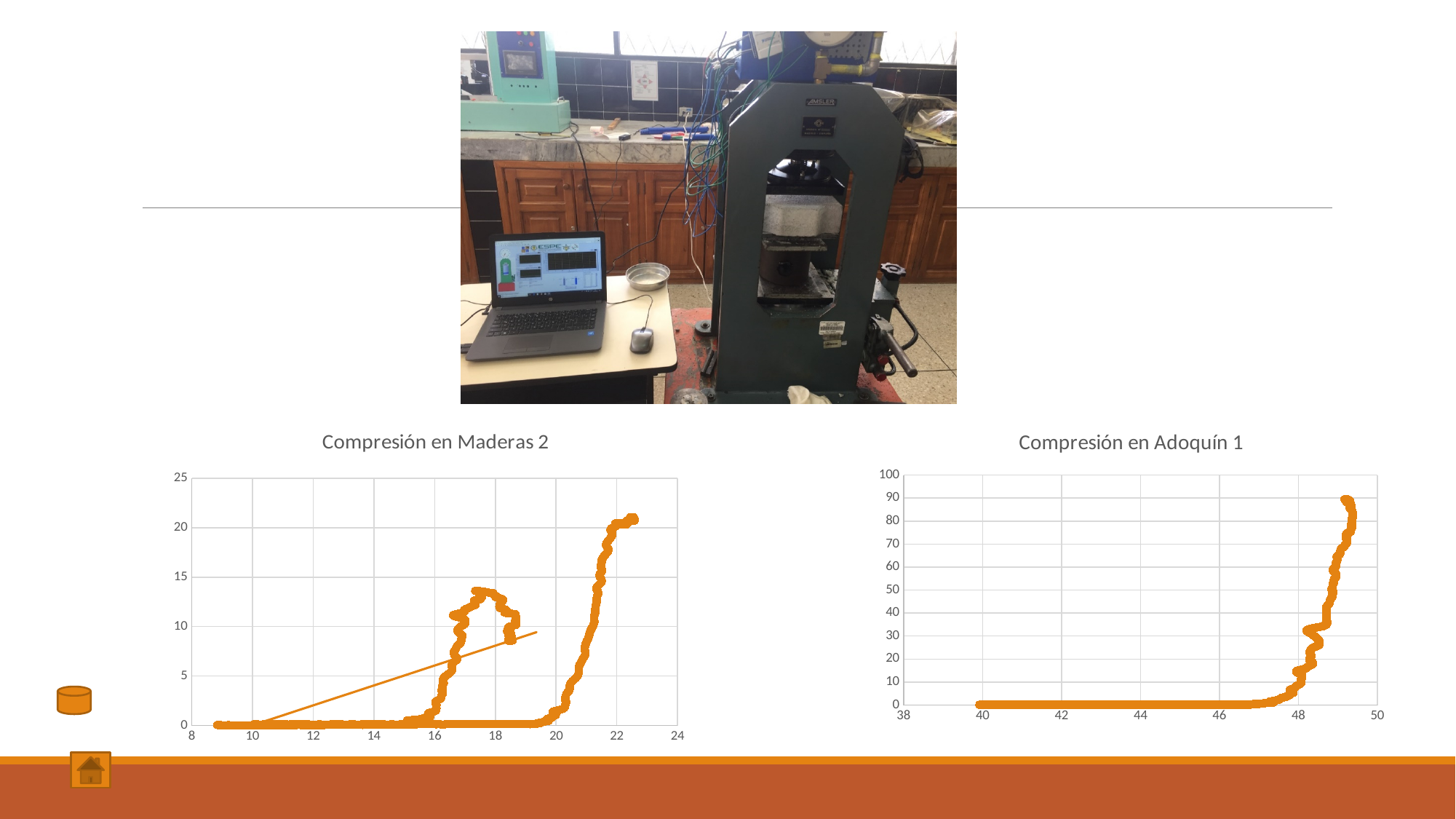
In "Compresión en Adoquín 1", is the highest plotted value greater or less than 80? greater In "Compresión en Adoquín 1", do the plotted values rise or fall as x increases from 46 to 49? rise What is the highest value shown on the y axis of "Compresión en Maderas 2"? 25 What is the highest value shown on the y axis of "Compresión en Adoquín 1"? 100 Which chart reaches a higher maximum plotted value, "Compresión en Maderas 2" or "Compresión en Adoquín 1"? Compresión en Adoquín 1 What kind of chart is "Compresión en Maderas 2"? scatter chart In "Compresión en Maderas 2", is the plotted value at x = 12 greater or less than 5? less What kind of chart is "Compresión en Adoquín 1"? scatter chart In "Compresión en Maderas 2", do the plotted values rise or fall as x increases from 20 to 22? rise In "Compresión en Adoquín 1", is the plotted value at x = 44 greater or less than 10? less